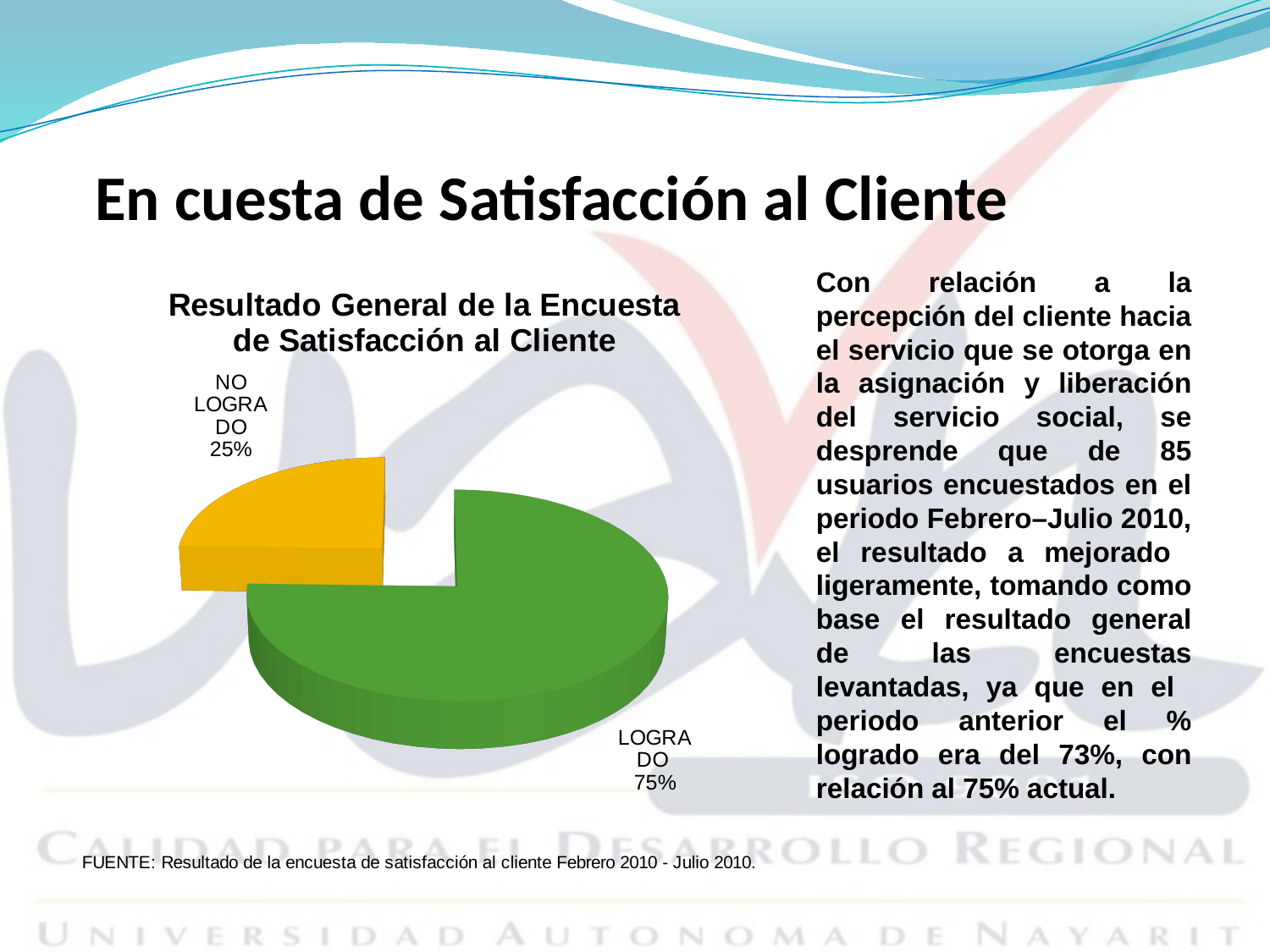
Which slice of the pie is the largest? LOGRADO What percentage is shown for NO LOGRADO? 25% Which slice of the pie is the smallest? NO LOGRADO What percentage is shown for LOGRADO? 75% What colour is the LOGRADO slice? Green What share of the pie does NO LOGRADO represent? 25% What kind of chart is shown on the slide? Pie chart What is the title of the chart? Resultado General de la Encuesta de Satisfacción al Cliente What is the difference in percentage points between LOGRADO and NO LOGRADO? 50 Which is larger, the LOGRADO slice or the NO LOGRADO slice? LOGRADO How many slices does the pie chart have? 2